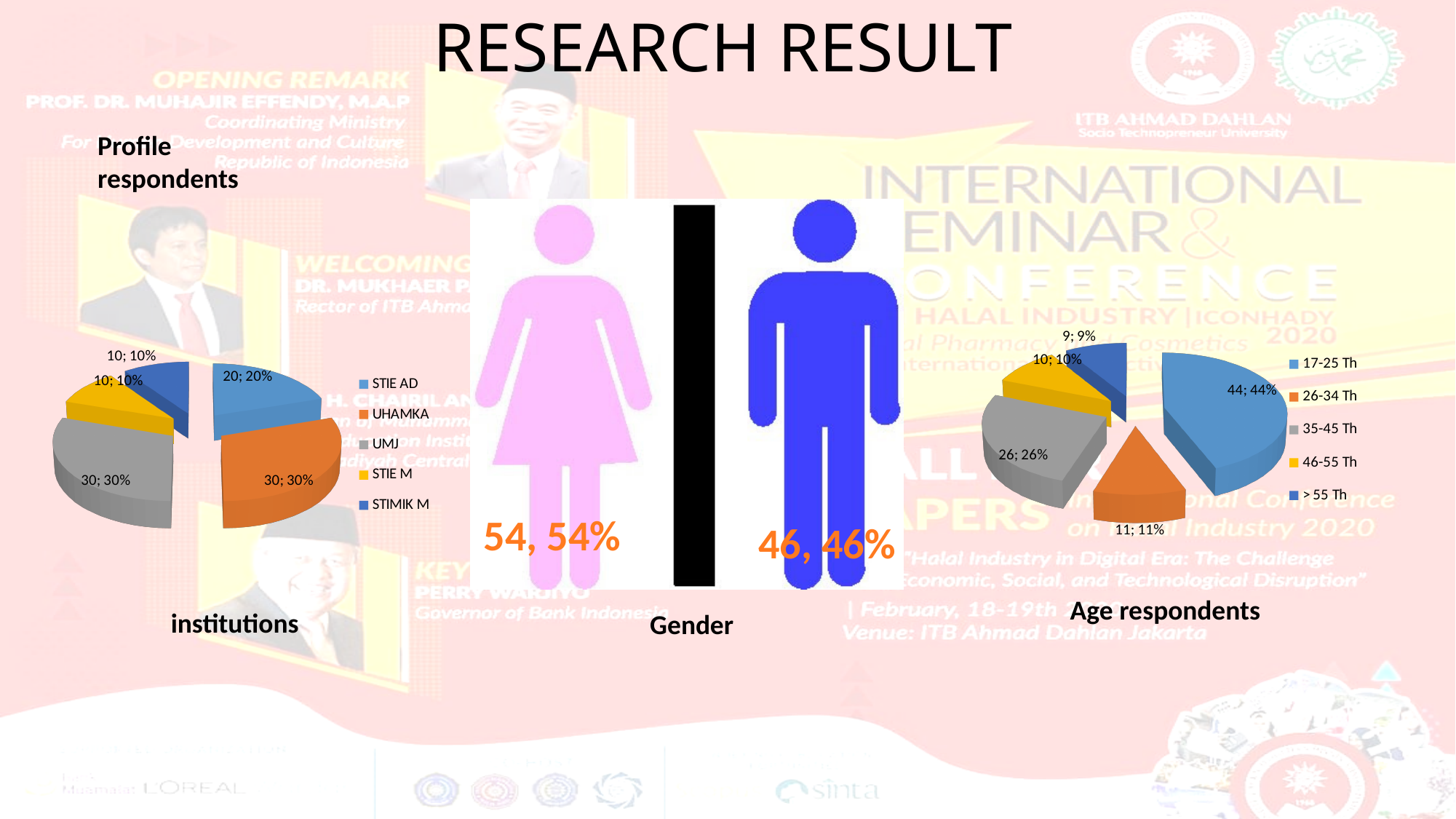
In the Age respondents pie chart, which colour represents the 46-55 Th group? Yellow In the institutions pie chart, what is the value shown for STIE AD? 20; 20% In the Age respondents pie chart, what is the difference in count between the 17-25 Th group and the 26-34 Th group? 33 In the institutions pie chart, what share of respondents is from UHAMKA? 30% In the Age respondents pie chart, which age group has the largest share? 17-25 Th What type of chart is the institutions chart? Pie chart How many entries does the legend of the Age respondents pie chart list? 5 In the Age respondents pie chart, what is the value shown for 35-45 Th? 26; 26% In the institutions pie chart, what is the combined share of UHAMKA and UMJ? 60% How many categories does the institutions pie chart show? 5 In the Age respondents pie chart, which age group has the smallest share? > 55 Th In the institutions pie chart, which institution has the smallest share, STIE AD or STIE M? STIE M